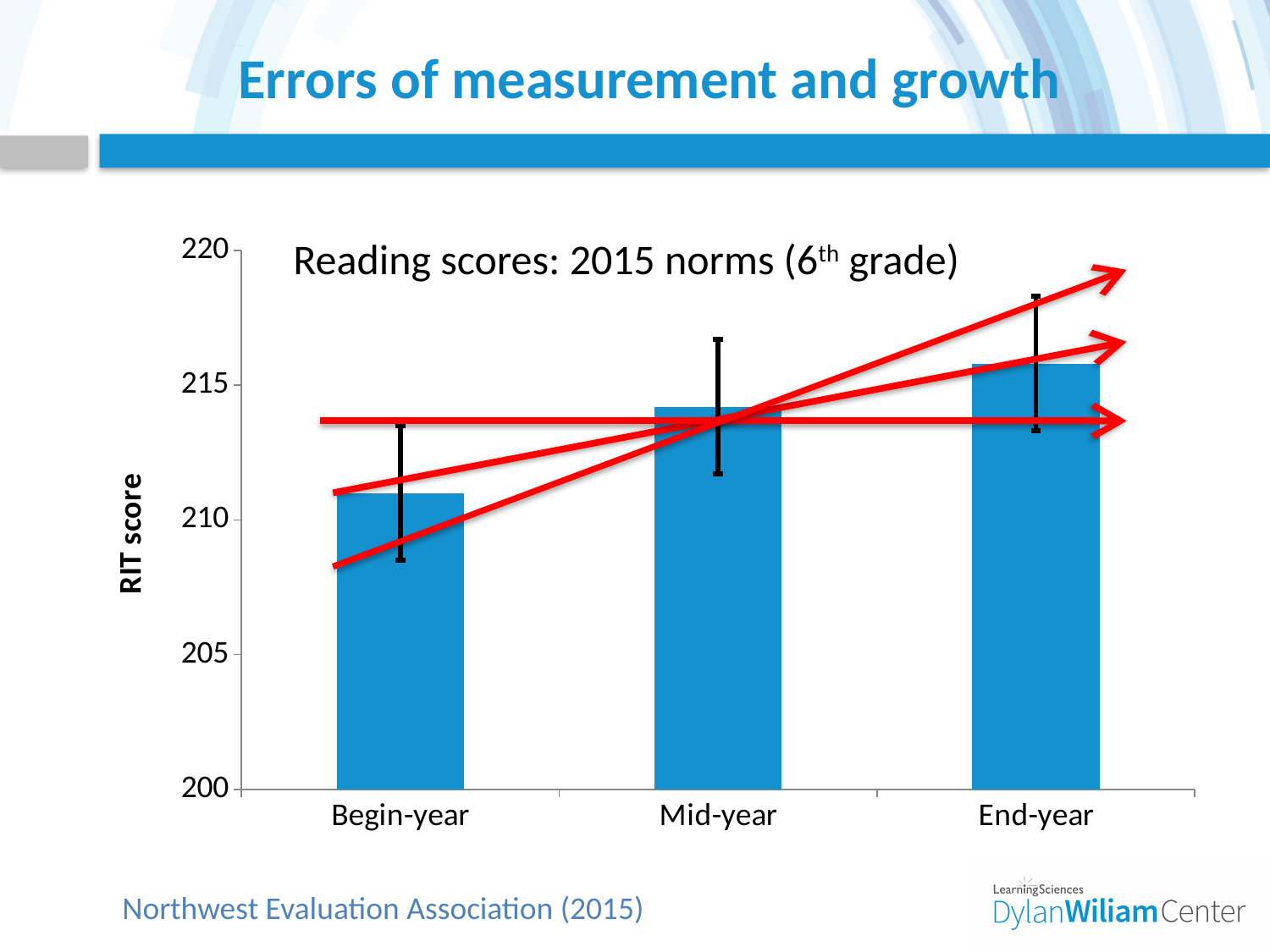
What is the title of the chart? Reading scores: 2015 norms (6th grade) Is the value for End-year greater or less than 215? greater How many categories are shown on the x axis of the chart? 3 Is the value for Begin-year greater or less than 210? greater What kind of chart is shown on the slide? Bar chart What is the label on the vertical axis of the chart? RIT score Is the value for Mid-year greater or less than 215? less Which category has the highest RIT score? End-year Which is larger, the RIT score for End-year or for Mid-year? End-year Do the RIT scores rise or fall from Begin-year to End-year? Rise Which is larger, the RIT score for Mid-year or for Begin-year? Mid-year Which category has the lowest RIT score? Begin-year